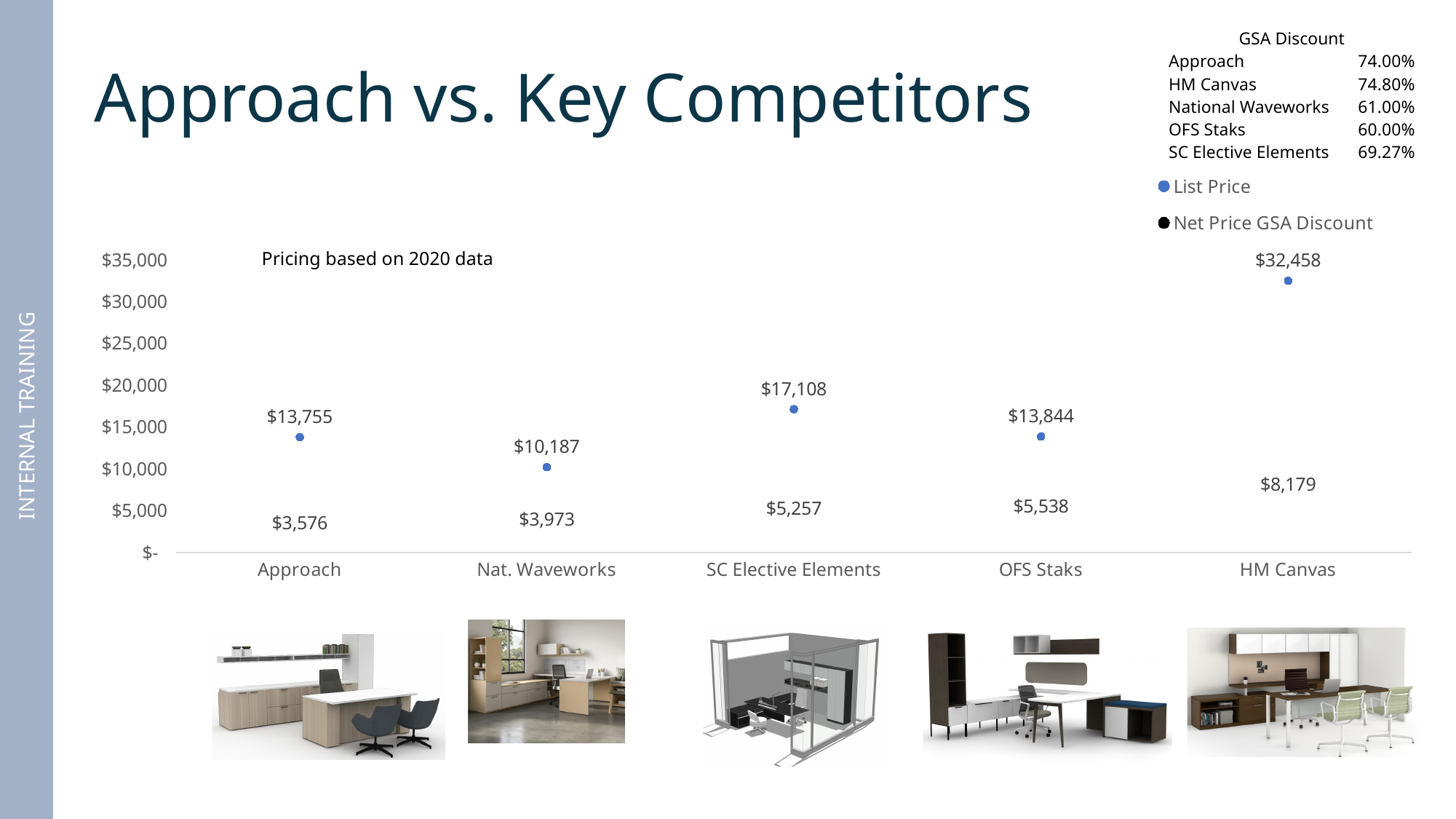
What is the difference between the List Price and the Net Price GSA Discount for SC Elective Elements? $11,851 How many series does the chart legend list? 2 How many categories are shown on the x axis of the chart? 5 Is the List Price for HM Canvas greater or less than $30,000? greater What is the Net Price GSA Discount for OFS Staks? $5,538 What is the Net Price GSA Discount for Approach? $3,576 What is the List Price for HM Canvas? $32,458 Which is larger, the List Price for SC Elective Elements or the List Price for OFS Staks? SC Elective Elements What note about the data is printed inside the chart area? Pricing based on 2020 data Which category has the highest List Price? HM Canvas What is the List Price for Nat. Waveworks? $10,187 Which category has the lowest Net Price GSA Discount? Approach